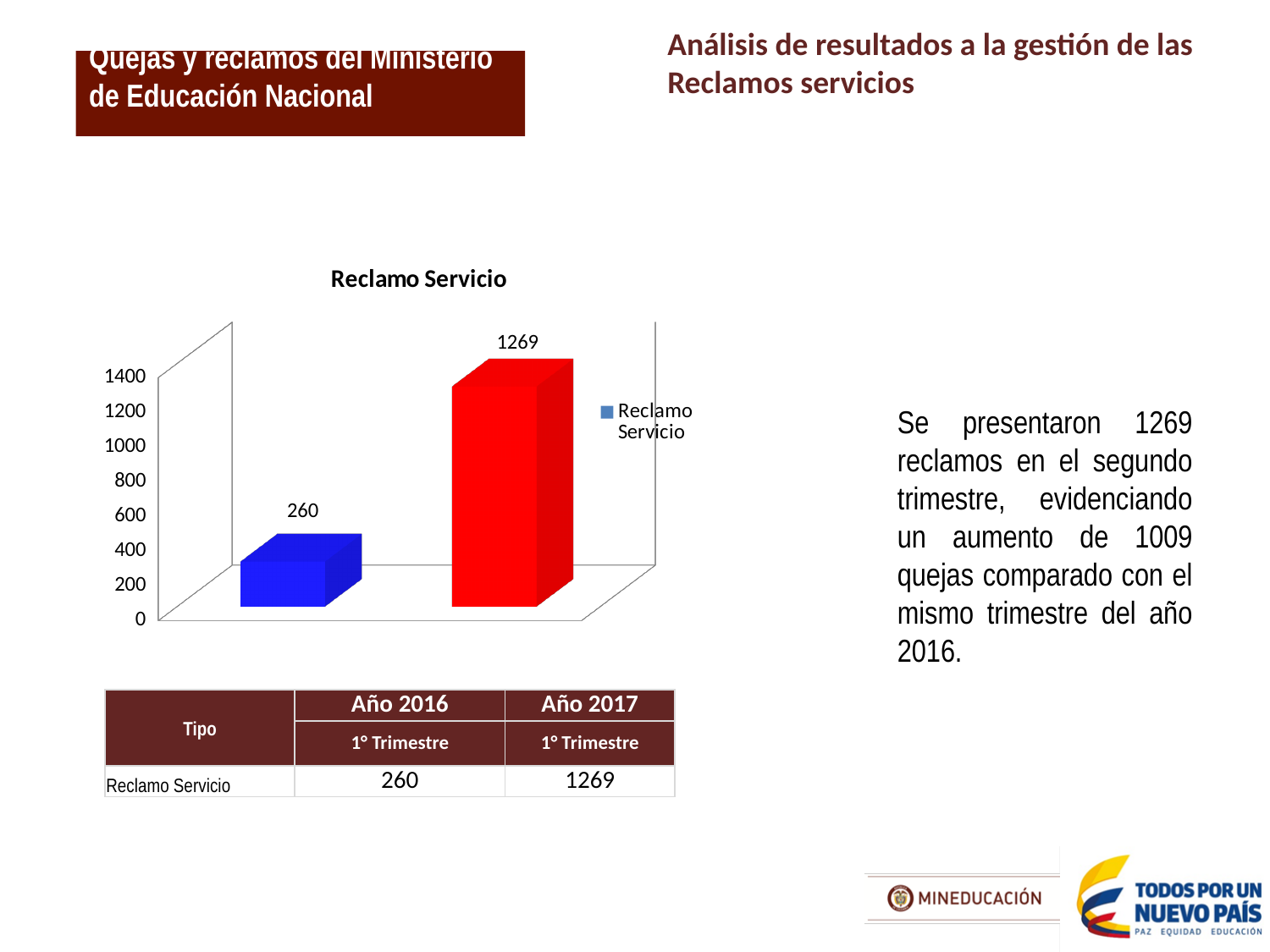
Do the values in the "Reclamo Servicio" chart rise or fall from left to right? rise What type of chart is shown under the title "Reclamo Servicio"? bar chart Is the value of the blue bar in the "Reclamo Servicio" chart greater or less than 400? less Which bar in the "Reclamo Servicio" chart has the lowest value, the blue one or the red one? the blue one How many series does the legend of the "Reclamo Servicio" chart list? 1 How many bars are plotted in the "Reclamo Servicio" chart? 2 What is the value shown on the red bar in the "Reclamo Servicio" chart? 1269 What is the difference between the red bar and the blue bar in the "Reclamo Servicio" chart? 1009 Which bar in the "Reclamo Servicio" chart has the highest value, the blue one or the red one? the red one What is the title of the chart? Reclamo Servicio Is the value of the red bar in the "Reclamo Servicio" chart greater or less than 1000? greater What is the value shown on the blue bar in the "Reclamo Servicio" chart? 260